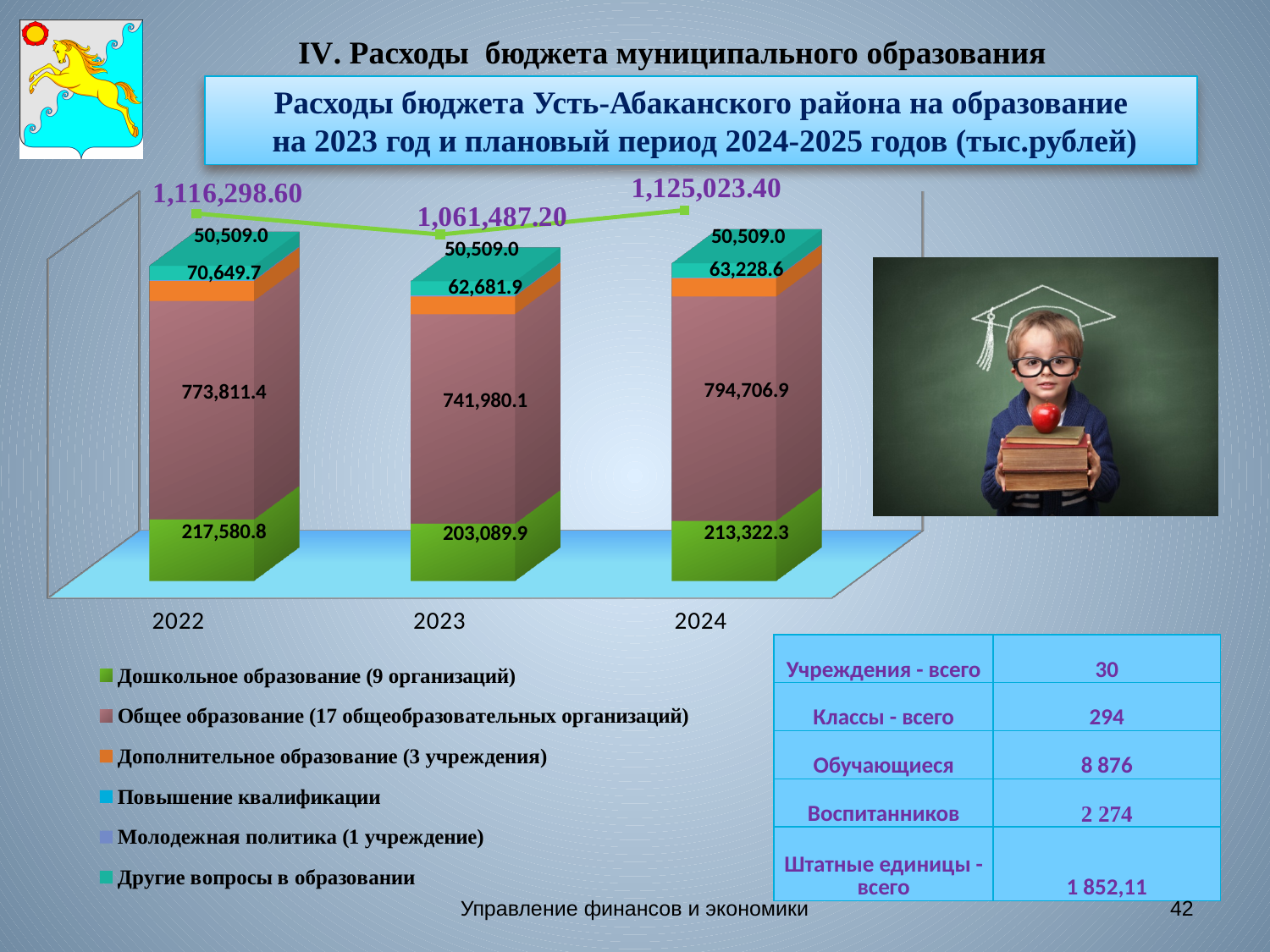
Which year has the highest total education expenditure? 2024 Which year has the larger value for Общее образование, 2022 or 2024? 2024 Which year has the lowest value for Общее образование? 2023 What is the difference between the Общее образование values for 2024 and 2023? 52,726.8 What kind of chart is shown on the slide? Stacked bar chart What is the total education expenditure shown for 2023? 1,061,487.20 What is the value for Дошкольное образование in 2022? 217,580.8 Does the total education expenditure rise or fall from 2023 to 2024? Rise What is the difference between the Дошкольное образование values for 2022 and 2023? 14,490.9 How many years are shown on the x axis of the chart? 3 How many series does the legend list? 6 What is the value for Общее образование in 2024? 794,706.9